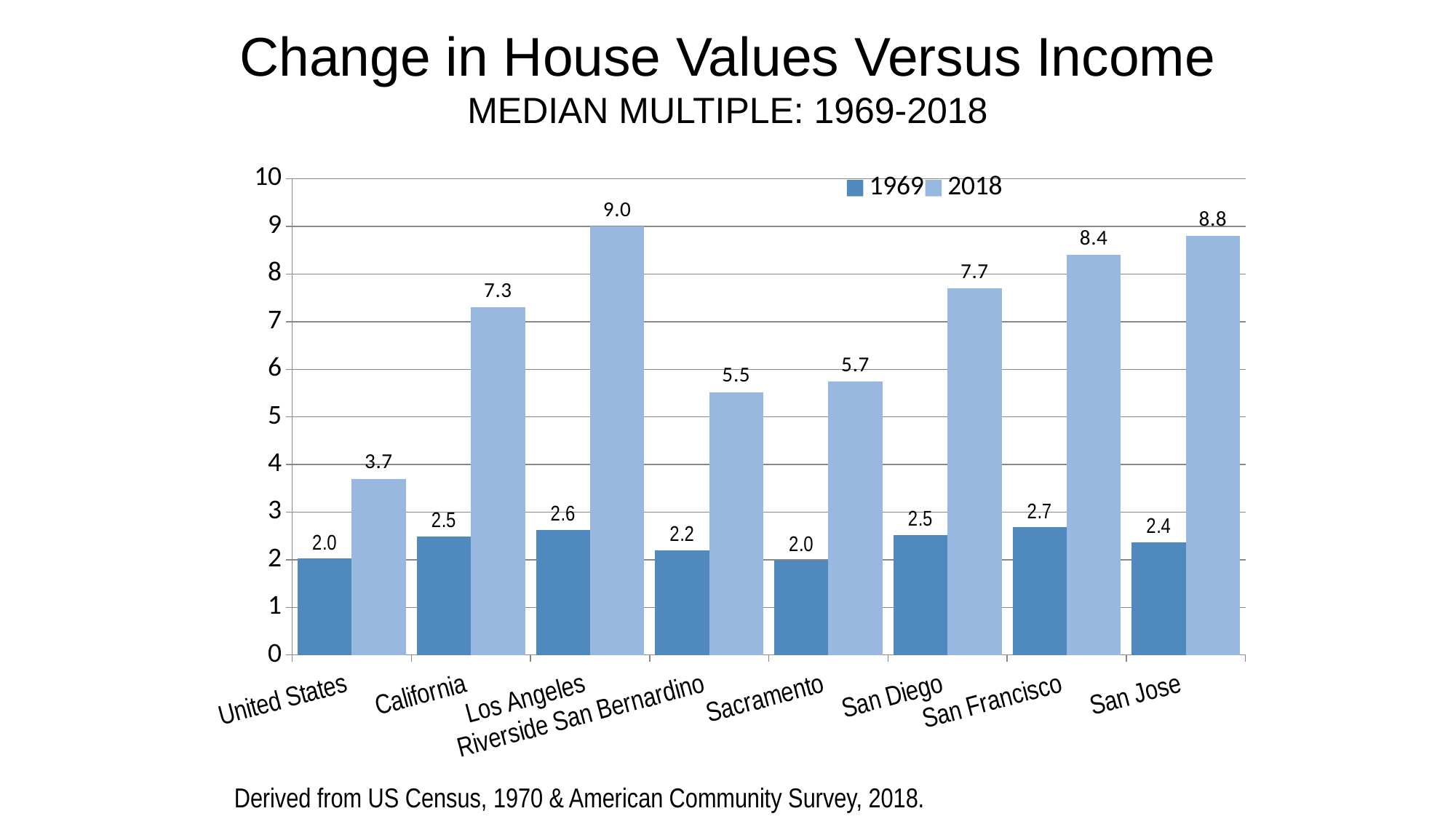
What kind of chart is shown on the slide? bar chart What is the 2018 median multiple for Los Angeles? 9.0 Which category has the lowest 2018 value? United States Which is larger, the 2018 value for San Diego or the 2018 value for Sacramento? San Diego What is the difference between the 2018 and 1969 values for San Jose? 6.4 Is the 2018 value for Riverside San Bernardino greater or less than 5? greater What is the subtitle of the chart? MEDIAN MULTIPLE: 1969-2018 How many categories are shown on the x axis? 8 How many series does the legend list? 2 What is the 2018 value for the United States? 3.7 What is the 1969 median multiple for San Francisco? 2.7 Which category has the highest 2018 value? Los Angeles